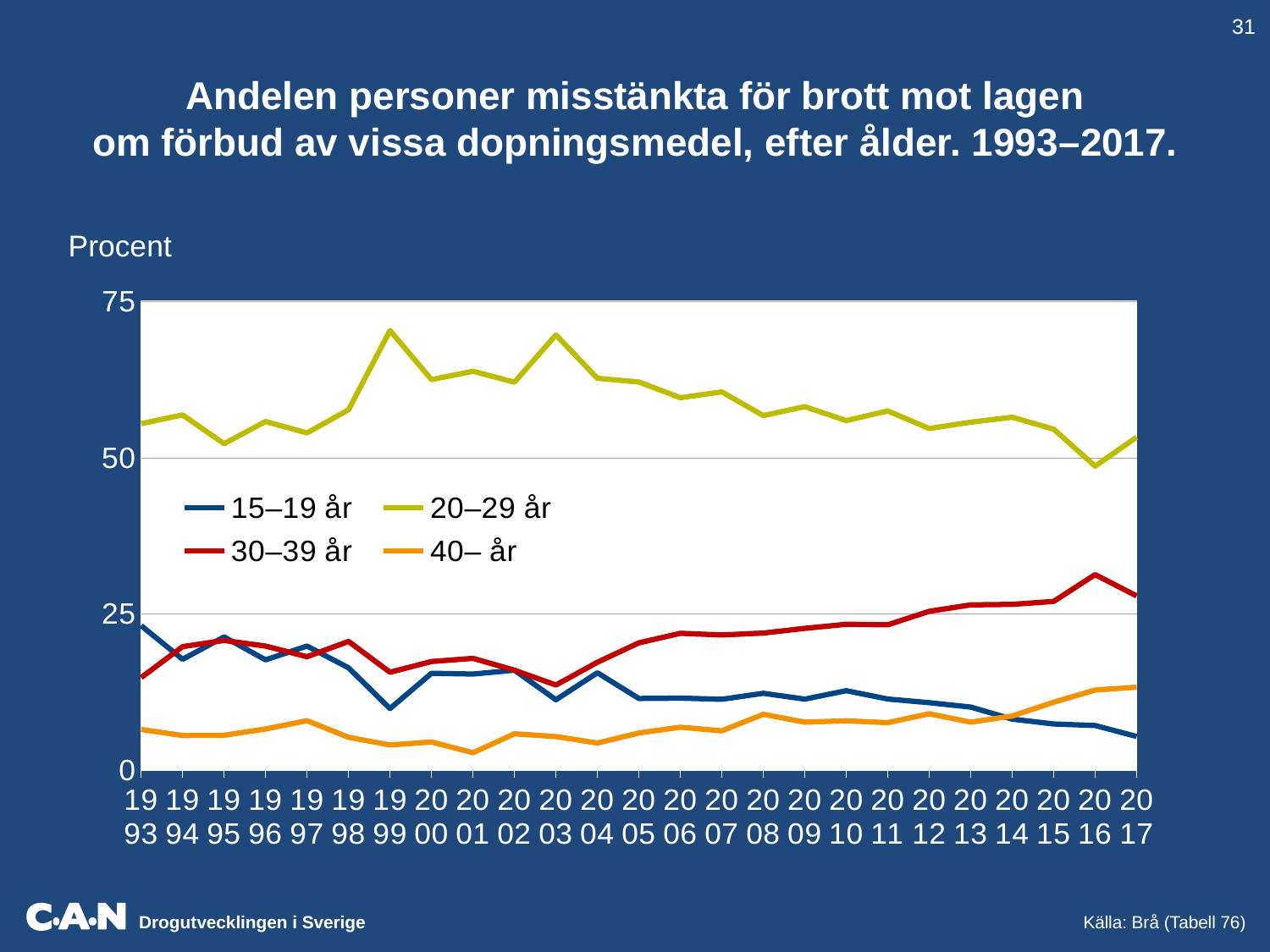
How many series does the legend list? 4 In 1993, which is larger: the value for 15–19 år or the value for 30–39 år? 15–19 år In 2017, which is larger: the value for 30–39 år or the value for 15–19 år? 30–39 år Which age group has the lowest share in 1993? 40– år Is the value for 15–19 år in 2017 greater or less than 25? less Does the 30–39 år series rise or fall overall from 1993 to 2017? rise Is the value for 20–29 år in 1999 greater or less than 50? greater What kind of chart is shown on the slide? line chart Which age group has the highest share in 2017? 20–29 år What label is shown on the y axis of the chart? Procent How many years are plotted along the x axis? 25 Is the value for 30–39 år in 2016 greater or less than 25? greater